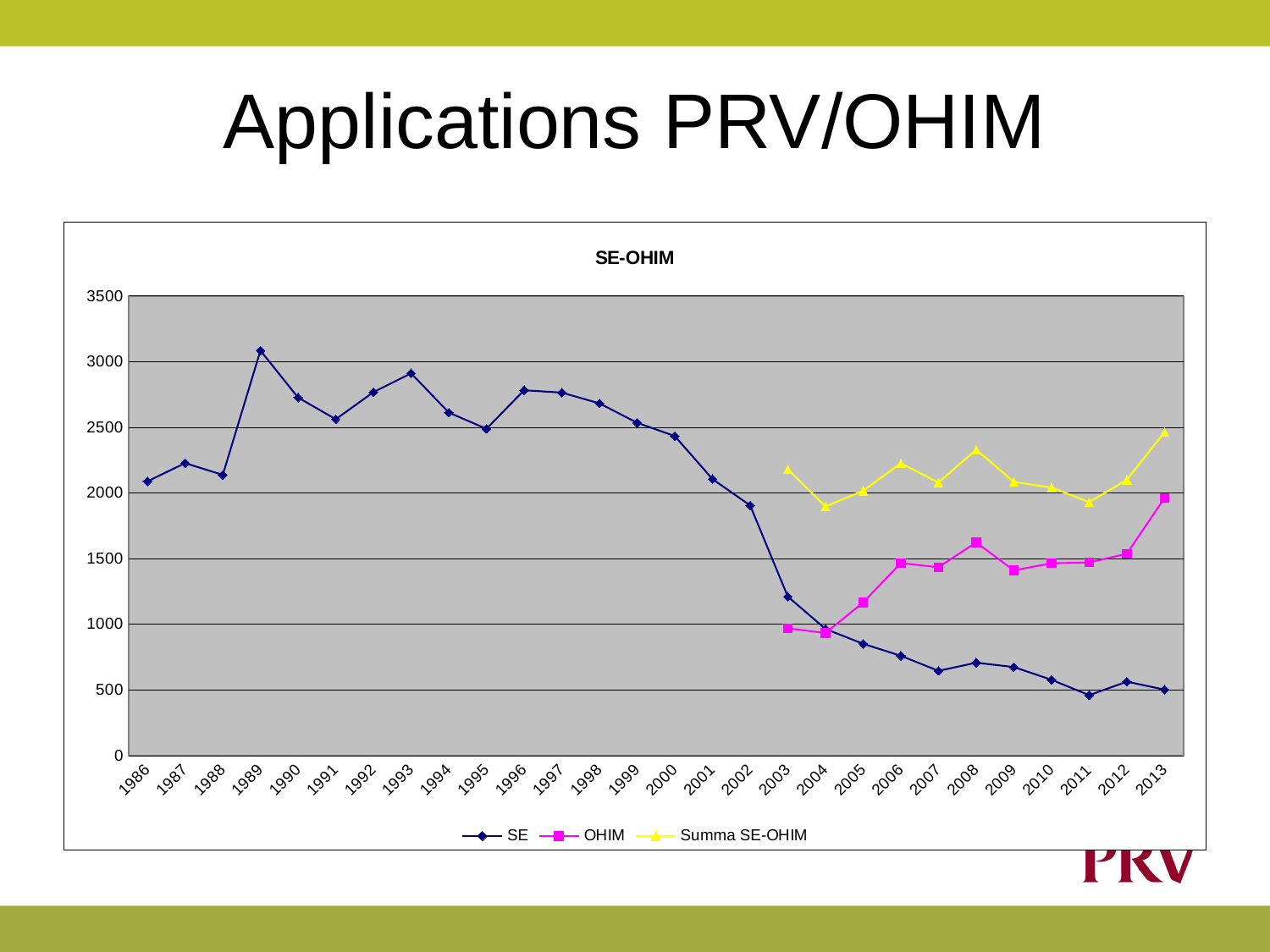
In which year does the SE series reach its highest value? 1989 In which year does the SE series reach its lowest value? 2011 In which year does the OHIM series reach its highest value? 2013 What is the title of the chart? SE-OHIM Is the value for OHIM in 2013 greater or less than 1500? greater How many series does the legend list? 3 Which is larger in 2013, the SE value or the OHIM value? OHIM What kind of chart is shown on the slide? line chart How many years are shown on the x axis? 28 Which series is drawn in yellow with triangle markers? Summa SE-OHIM Is the value for SE in 1989 greater or less than 3000? greater Does the SE series rise or fall between 2000 and 2011? fall